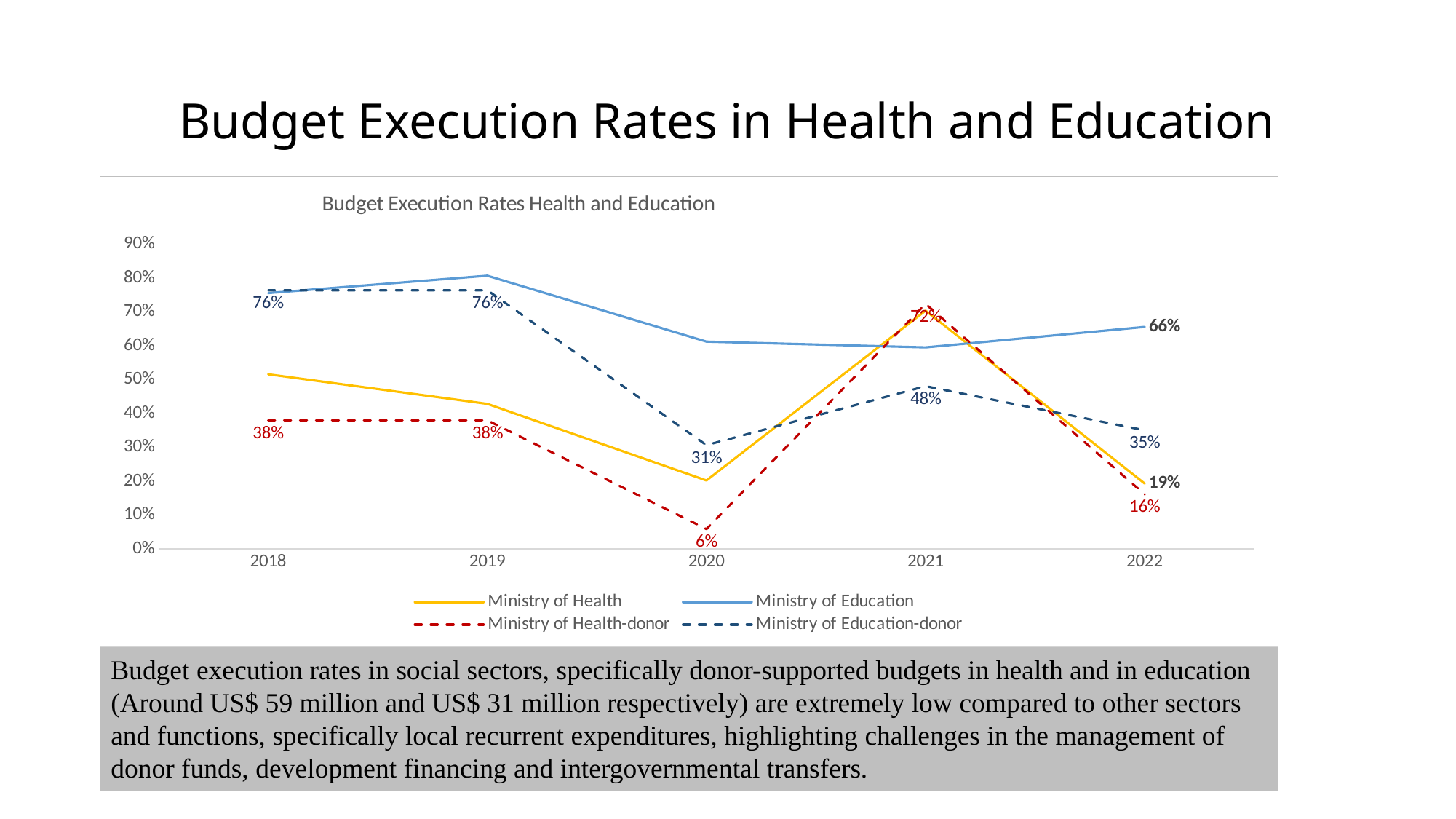
How many years are shown on the x axis? 5 How many series does the legend list? 4 Is the value for Ministry of Education in 2019 greater or less than 70%? greater What is the budget execution rate for Ministry of Health-donor in 2020? 6% What kind of chart is shown on the slide? line chart Does the Ministry of Health rate rise or fall from 2018 to 2020? fall What is the budget execution rate for Ministry of Education in 2022? 66% In which year is the Ministry of Health-donor rate highest? 2021 In 2022, which is larger: the Ministry of Education rate or the Ministry of Health rate? Ministry of Education In which year is the Ministry of Health-donor rate lowest? 2020 What is the budget execution rate for Ministry of Education-donor in 2021? 48% What is the difference between the Ministry of Education-donor rate in 2019 and in 2020? 45 percentage points